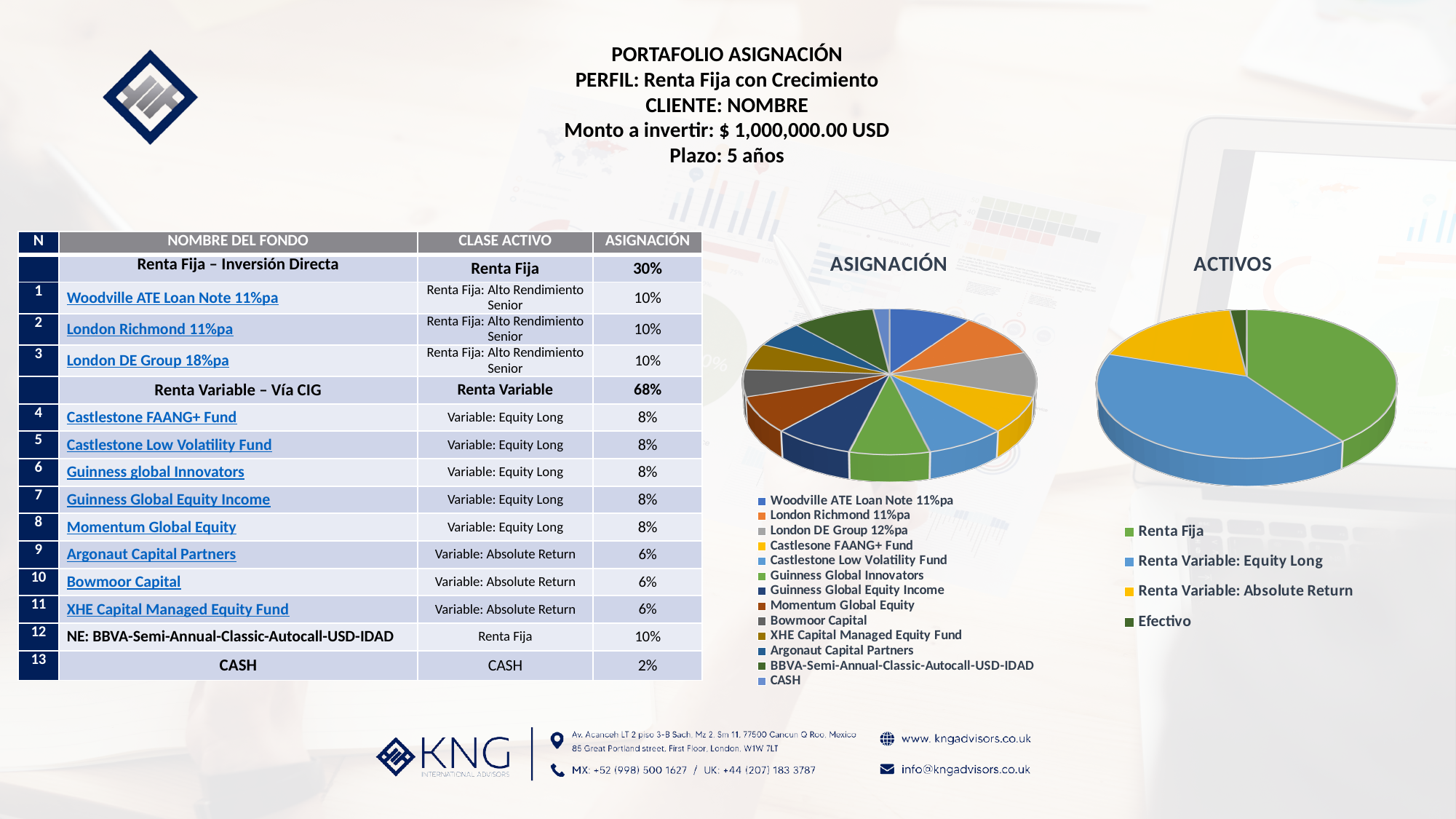
In the ACTIVOS chart, which slice is larger: Renta Variable: Absolute Return or Efectivo? Renta Variable: Absolute Return In the ASIGNACIÓN chart, which slice is the smallest? CASH How many entries does the legend of the ACTIVOS chart list? 4 What kind of chart is the ASIGNACIÓN chart? pie chart In the ACTIVOS chart, which slice is larger: Renta Fija or Renta Variable: Absolute Return? Renta Fija How many slices does the ACTIVOS pie chart have? 4 In the ACTIVOS chart, which slice is the smallest? Efectivo What kind of chart is the ACTIVOS chart? pie chart In the ACTIVOS chart legend, what colour represents Efectivo? dark green What is the title of the pie chart on the right side of the slide? ACTIVOS How many entries does the legend of the ASIGNACIÓN chart list? 13 In the ASIGNACIÓN chart, which slice is larger: Woodville ATE Loan Note 11%pa or CASH? Woodville ATE Loan Note 11%pa